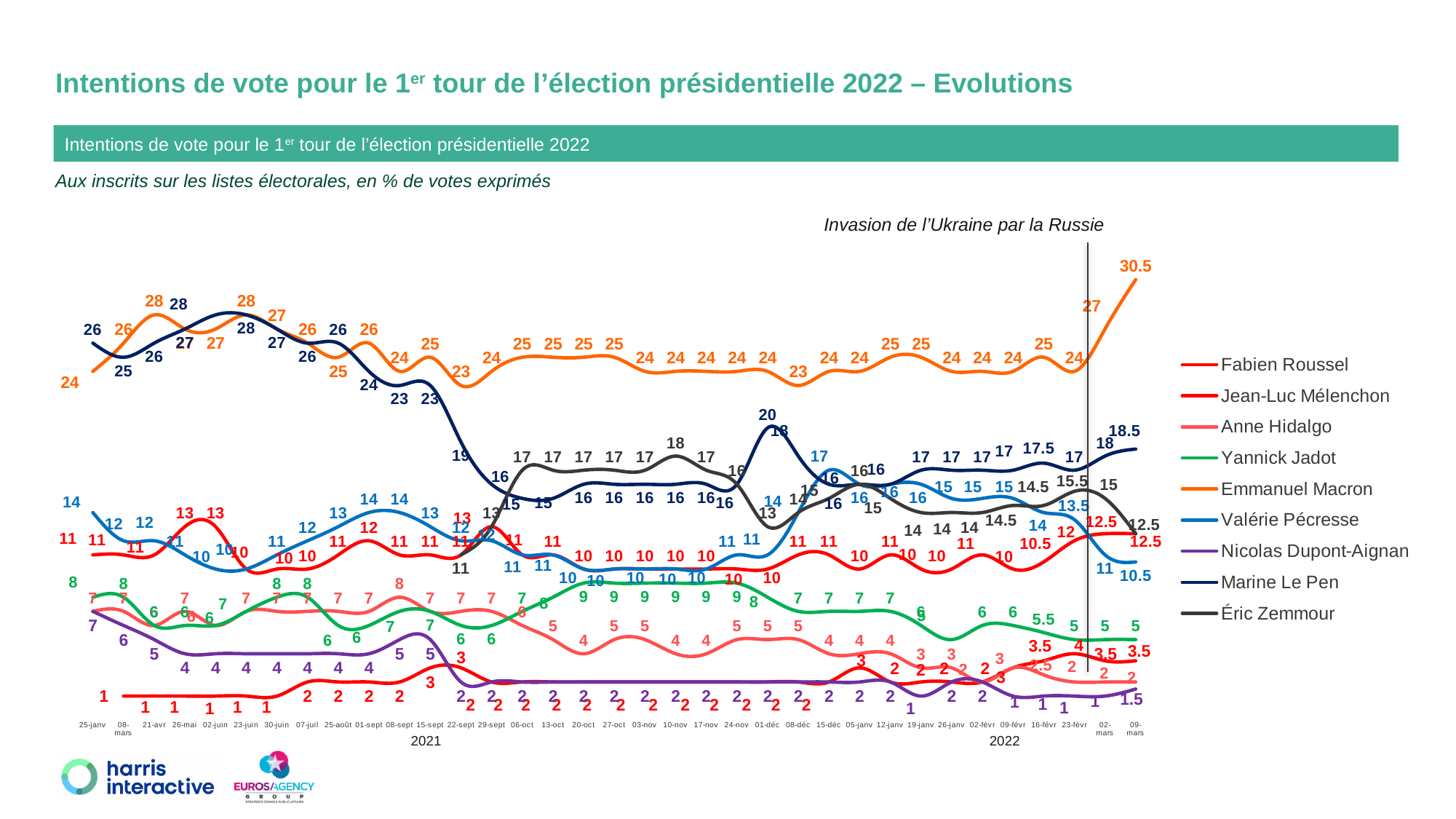
What type of chart is shown on the slide? Line chart How many series does the legend list? 9 Which candidate has the lowest value at 09-mars? Nicolas Dupont-Aignan What is the difference between Emmanuel Macron and Marine Le Pen at 09-mars? 12 Which candidate has the highest value at 09-mars? Emmanuel Macron Does Emmanuel Macron's line rise or fall between 23-févr and 09-mars? Rises At 25-janv, who has the larger value: Marine Le Pen or Emmanuel Macron? Marine Le Pen What is the value for Marine Le Pen at 09-mars? 18.5 What event is annotated with a vertical line on the chart? Invasion de l'Ukraine par la Russie What is the value for Valérie Pécresse at 09-mars? 10.5 What is the value for Emmanuel Macron at the last point (09-mars)? 30.5 What is the value for Emmanuel Macron at 02-mars? 27